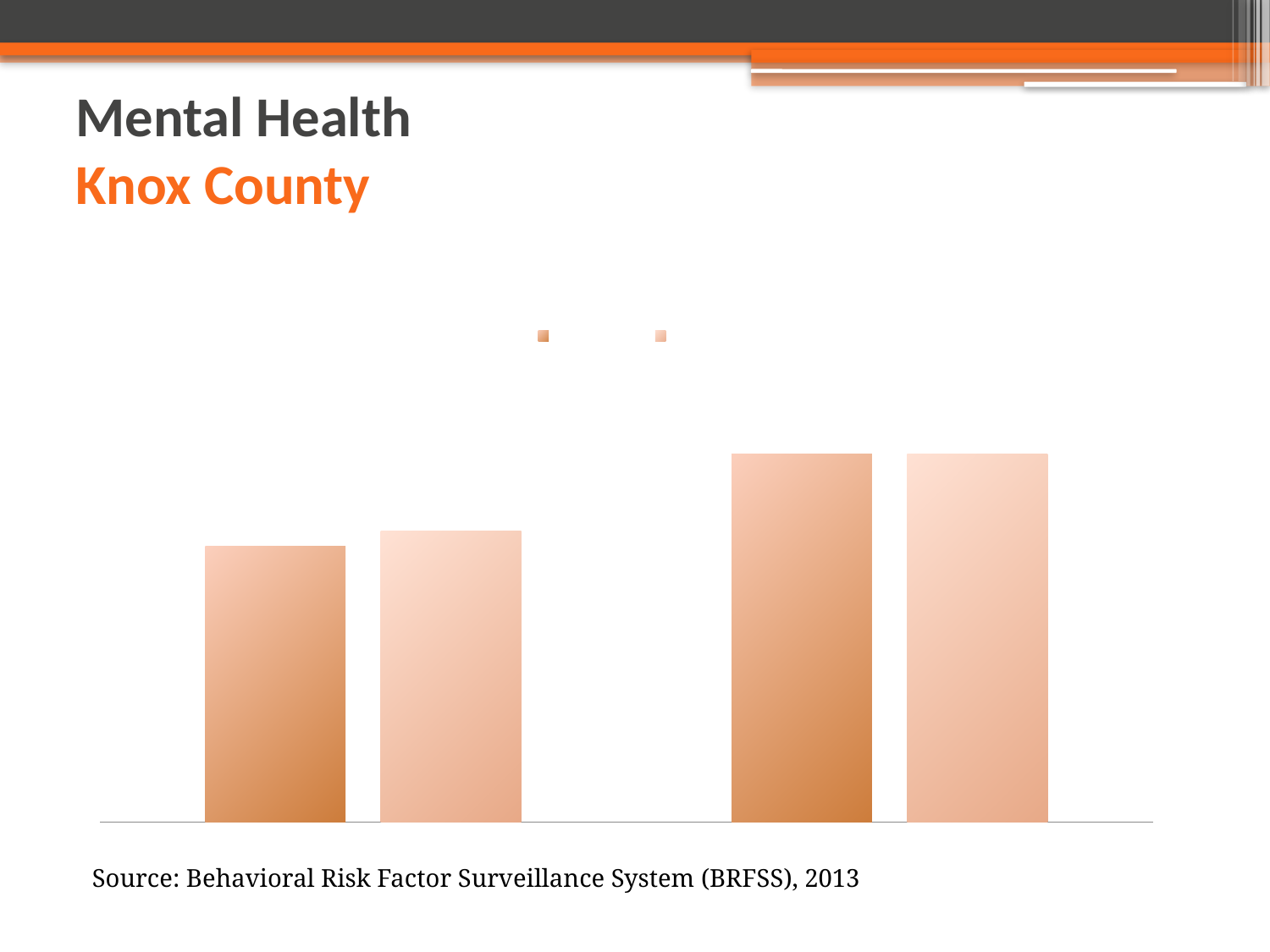
How many groups of bars are plotted in the chart? 2 Within the left group of bars, is the darker orange bar taller or shorter than the lighter orange bar? shorter How many series does the legend of the chart show? 2 What kind of chart is shown on the slide? bar chart Is the leftmost bar in the chart taller or shorter than the rightmost bar? shorter How many bars are plotted in the chart? 4 What colours are used for the two series in the chart? dark orange and light orange Which group of bars is taller in the chart, the left group or the right group? the right group